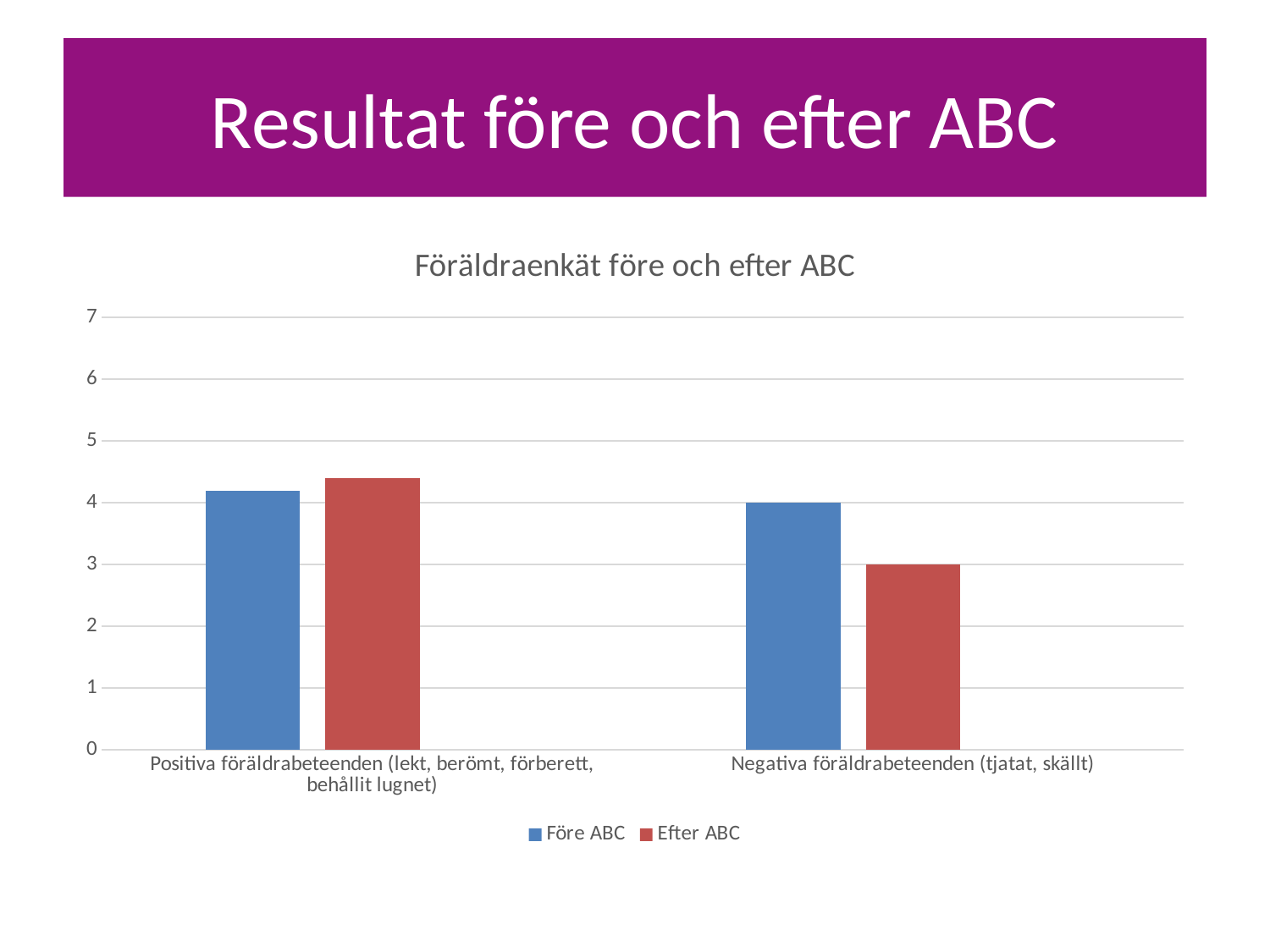
What is the value for Före ABC in the category Negativa föräldrabeteenden (tjatat, skällt)? 4 Which colour represents the Efter ABC series? red For Negativa föräldrabeteenden (tjatat, skällt), which is larger: Före ABC or Efter ABC? Före ABC What is the value for Efter ABC in the category Negativa föräldrabeteenden (tjatat, skällt)? 3 What is the difference between Före ABC and Efter ABC for Negativa föräldrabeteenden (tjatat, skällt)? 1 Which bar is the lowest in the chart? Efter ABC for Negativa föräldrabeteenden (tjatat, skällt) How many categories are shown on the x axis? 2 What type of chart is shown on the slide? bar chart How many series does the legend list? 2 Is the value for Före ABC in the category Positiva föräldrabeteenden greater or less than 4? greater Is the value for Efter ABC in the category Positiva föräldrabeteenden greater or less than 5? less What is the title of the chart? Föräldraenkät före och efter ABC